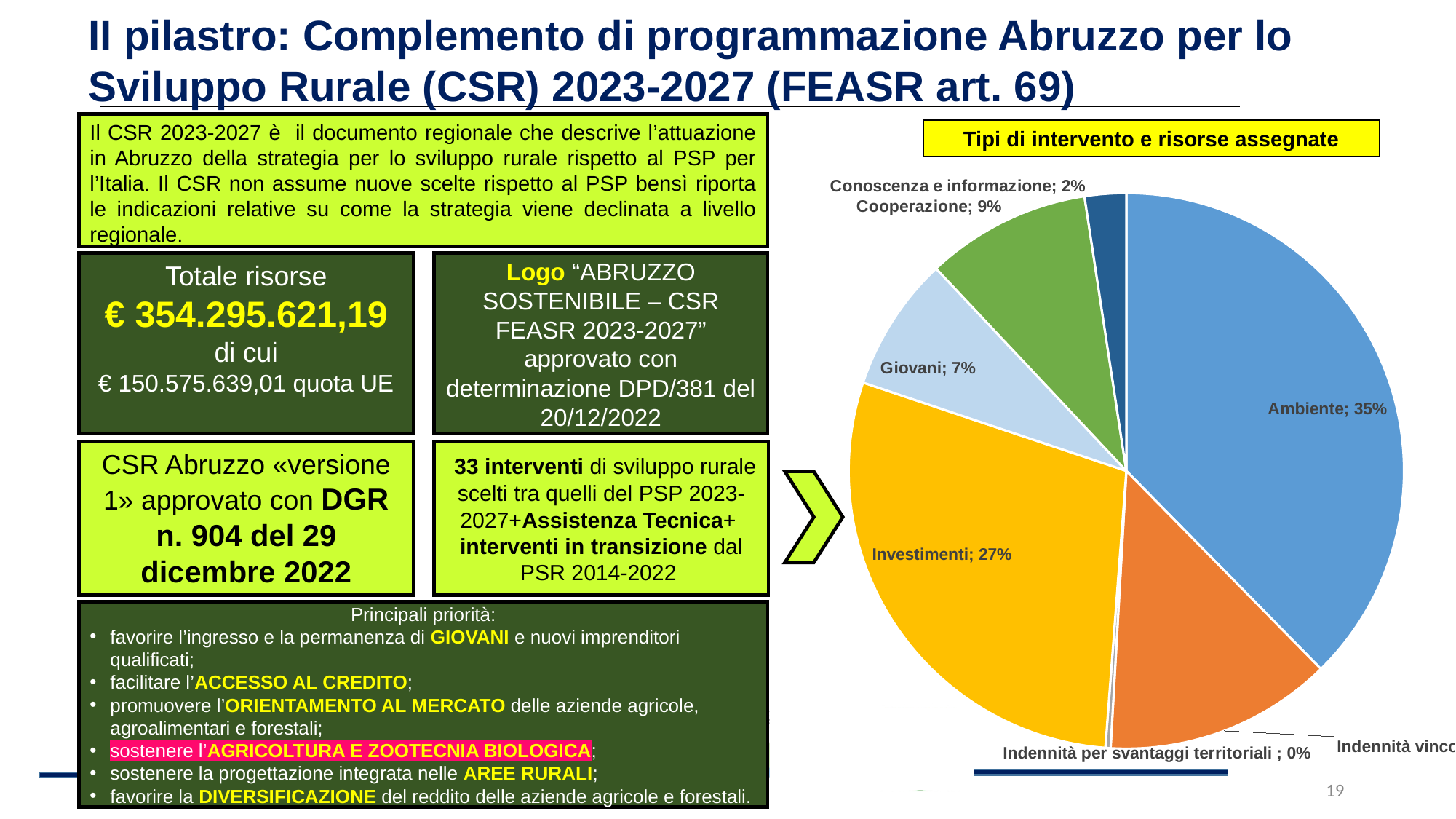
What type of chart is shown on the slide? Pie chart What share of the pie does Ambiente represent? 35% What share of the pie does Conoscenza e informazione represent? 2% What share of the pie does Investimenti represent? 27% Which labelled category has the smallest share of the pie? Indennità per svantaggi territoriali Which has a larger share of the pie, Cooperazione or Giovani? Cooperazione What is the title of the chart on the slide? Tipi di intervento e risorse assegnate What share of the pie does Giovani represent? 7% What is the difference in percentage points between the shares of Ambiente and Investimenti? 8 percentage points Which category has the largest share of the pie? Ambiente What share of the pie does Indennità per svantaggi territoriali represent? 0% What share of the pie does Cooperazione represent? 9%